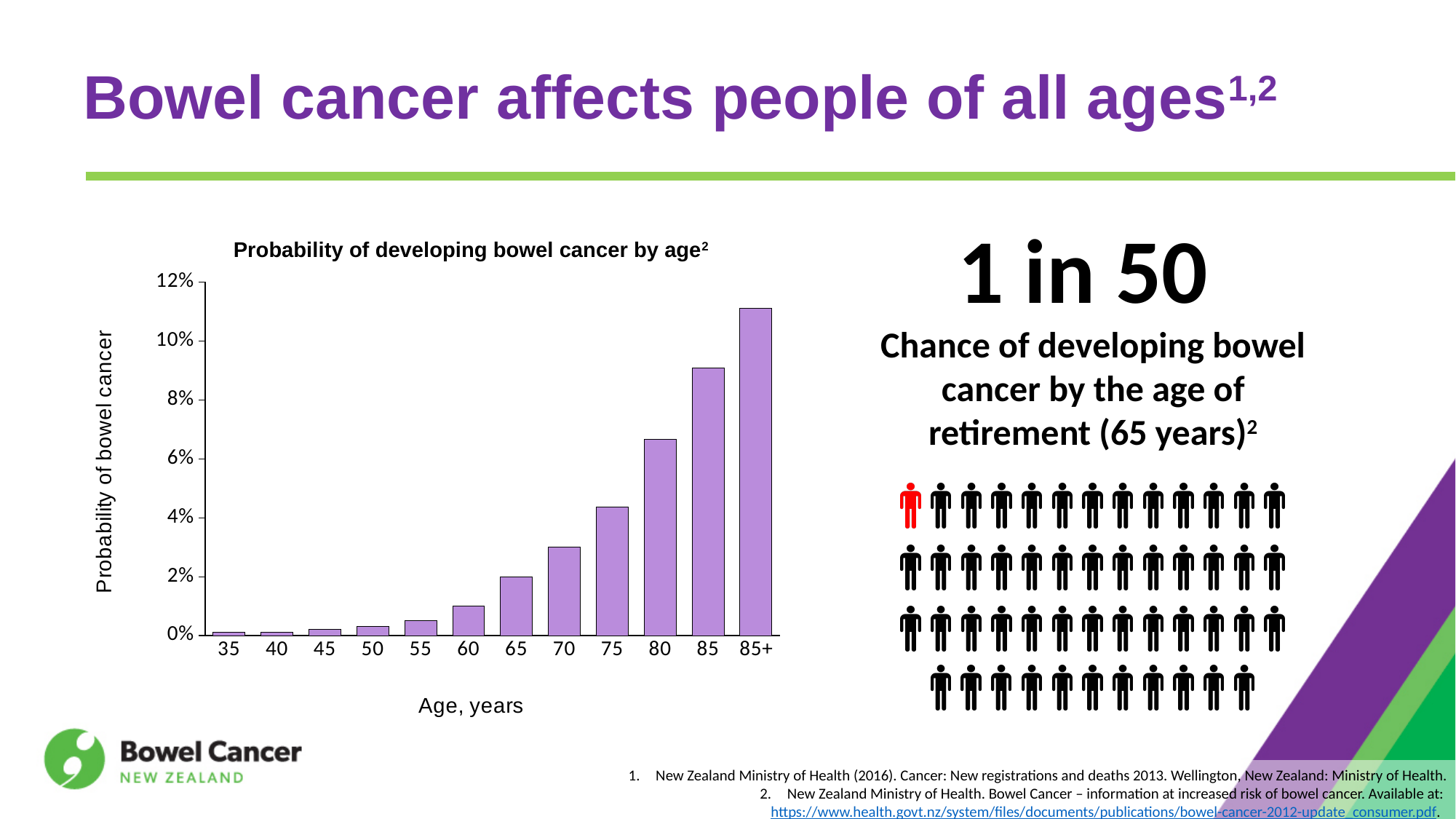
Is the value for age 85 greater or less than 10%? less Is the value for age 85+ greater or less than 10%? greater What kind of chart is shown on the slide? Bar chart What is the label of the y axis of the chart? Probability of bowel cancer Do the values rise or fall as age increases along the x axis? Rise How many age categories are shown on the x axis of the chart? 12 What is the title of the chart? Probability of developing bowel cancer by age Is the value for age 60 greater or less than 2%? less Which age category has the highest probability of developing bowel cancer? 85+ Which has a higher probability of developing bowel cancer, age 70 or age 80? 80